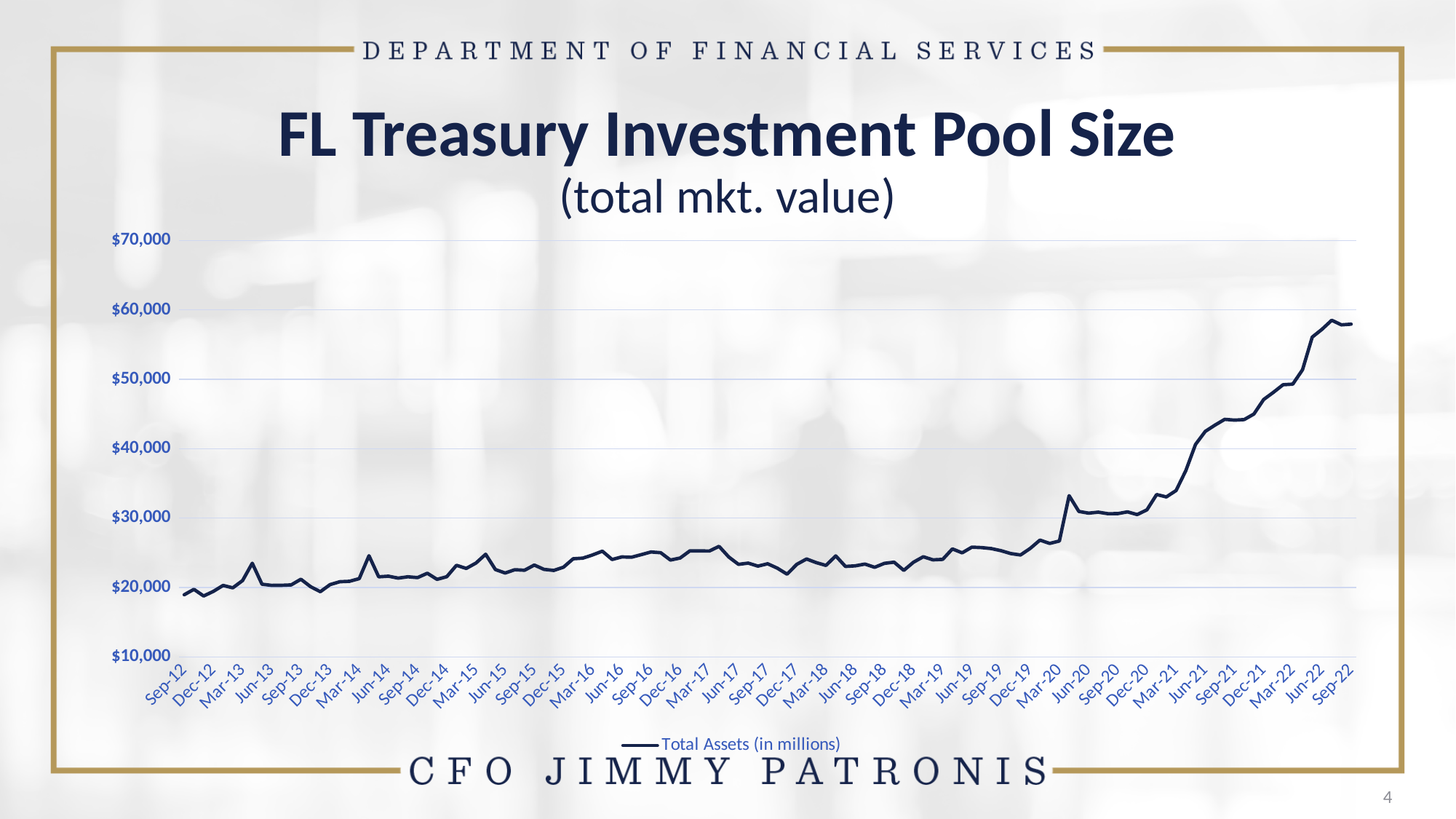
Is the value for Jun-20 greater or less than $30,000? greater What is the title of the chart? FL Treasury Investment Pool Size (total mkt. value) Is the value for Sep-12 greater or less than $20,000? less Is the value for Sep-22 greater or less than $50,000? greater Which is larger, the value for Jun-20 or the value for Mar-20? Jun-20 What kind of chart is shown on the slide? line chart Overall, do the values rise or fall from Sep-12 to Sep-22? rise How many series does the legend list? 1 What is the series name shown in the legend? Total Assets (in millions) Which is larger, the value for Sep-22 or the value for Sep-12? Sep-22